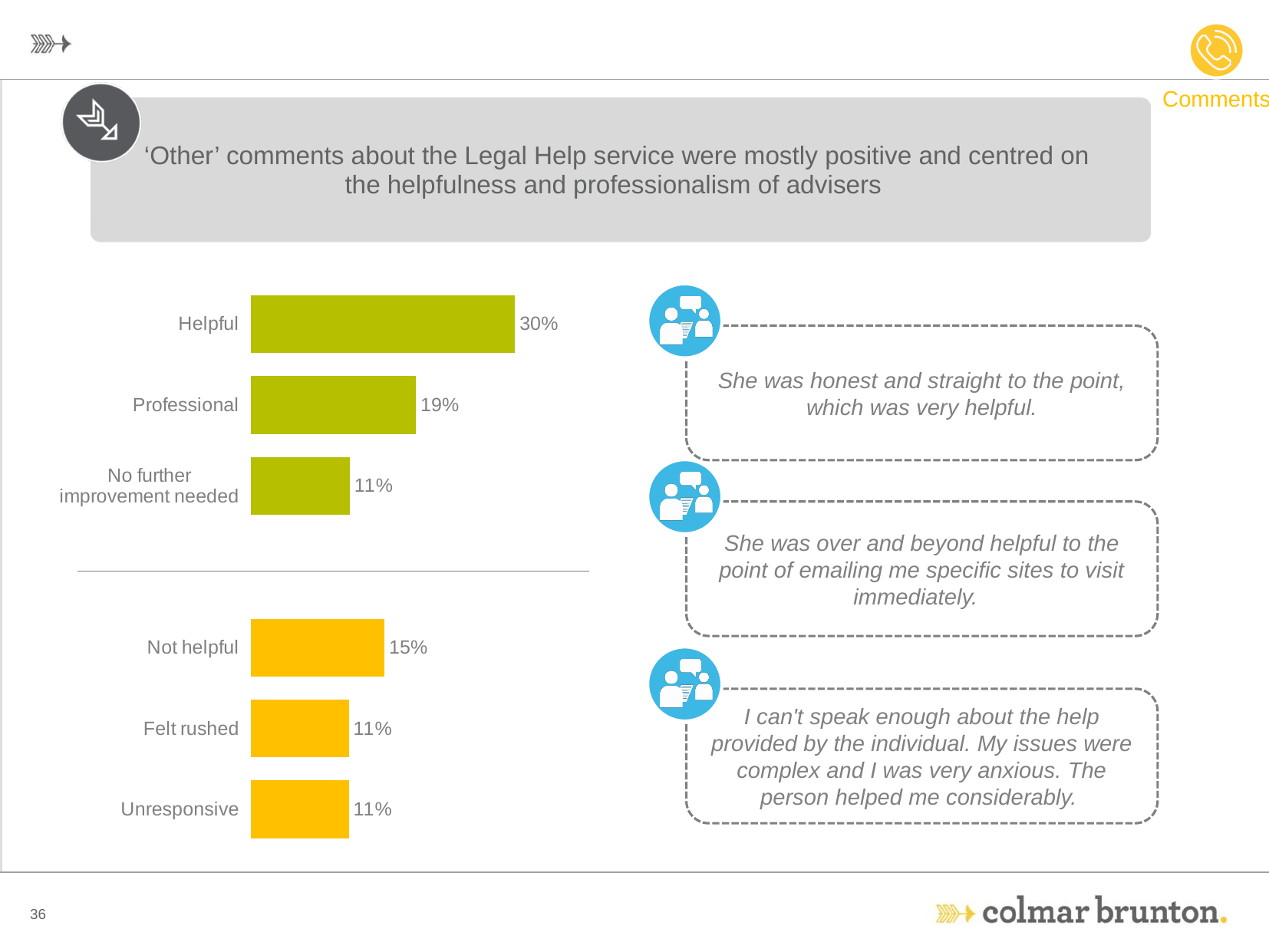
In the upper chart with green bars, which category has the highest value? Helpful How many categories are shown in the lower chart with yellow bars? 3 In the upper chart with green bars, what is the difference between the values for 'Helpful' and 'Professional'? 11% In the upper chart with green bars, what percentage of comments were 'Helpful'? 30% In the lower chart with yellow bars, what is the value for 'Not helpful'? 15% In the upper chart with green bars, what is the value for 'No further improvement needed'? 11% What type of chart is used to show the comment categories on this slide? Bar chart In the lower chart with yellow bars, what is the value for 'Felt rushed'? 11% Which is larger: the value for 'Professional' in the upper chart or the value for 'Not helpful' in the lower chart? Professional In the upper chart with green bars, what is the value for 'Professional'? 19% In the lower chart with yellow bars, what is the difference between 'Not helpful' and 'Unresponsive'? 4% In the lower chart with yellow bars, which category has the highest value? Not helpful